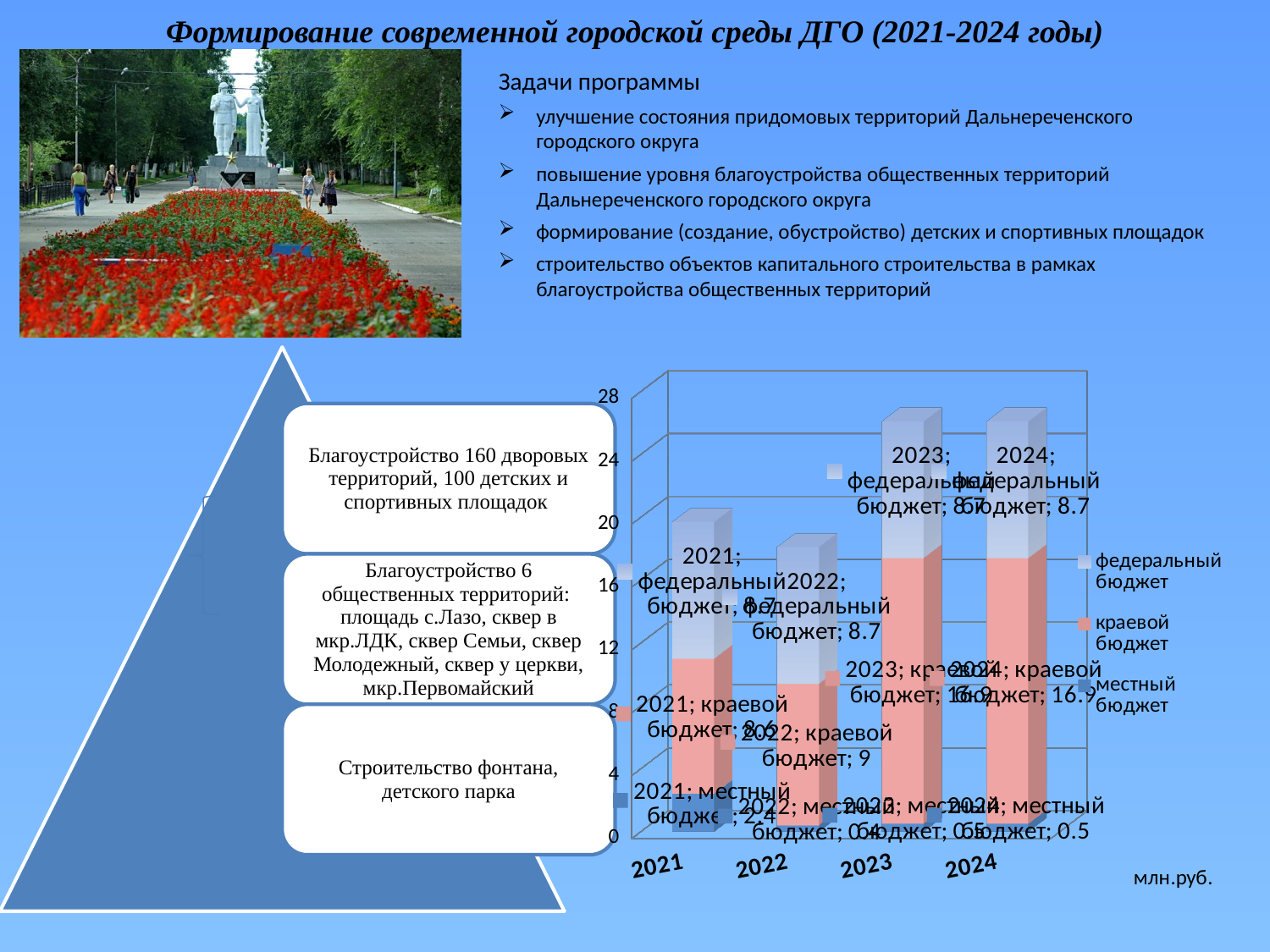
How many years (categories) are shown on the x axis of the chart? 4 What is the value of федеральный бюджет for 2022? 8.7 What kind of chart is shown on the slide? stacked bar chart What is the value of краевой бюджет for 2022? 9 What is the value of местный бюджет for 2021? 2.4 In which year is местный бюджет the highest? 2021 What is the difference between краевой бюджет in 2023 and in 2021? 8.3 How many series does the chart legend list? 3 Which is larger in 2022: краевой бюджет or федеральный бюджет? краевой бюджет What is the total of the stacked bar for 2021? 19.7 What unit is indicated for the chart values? млн.руб. What is the value of краевой бюджет for 2023? 16.9